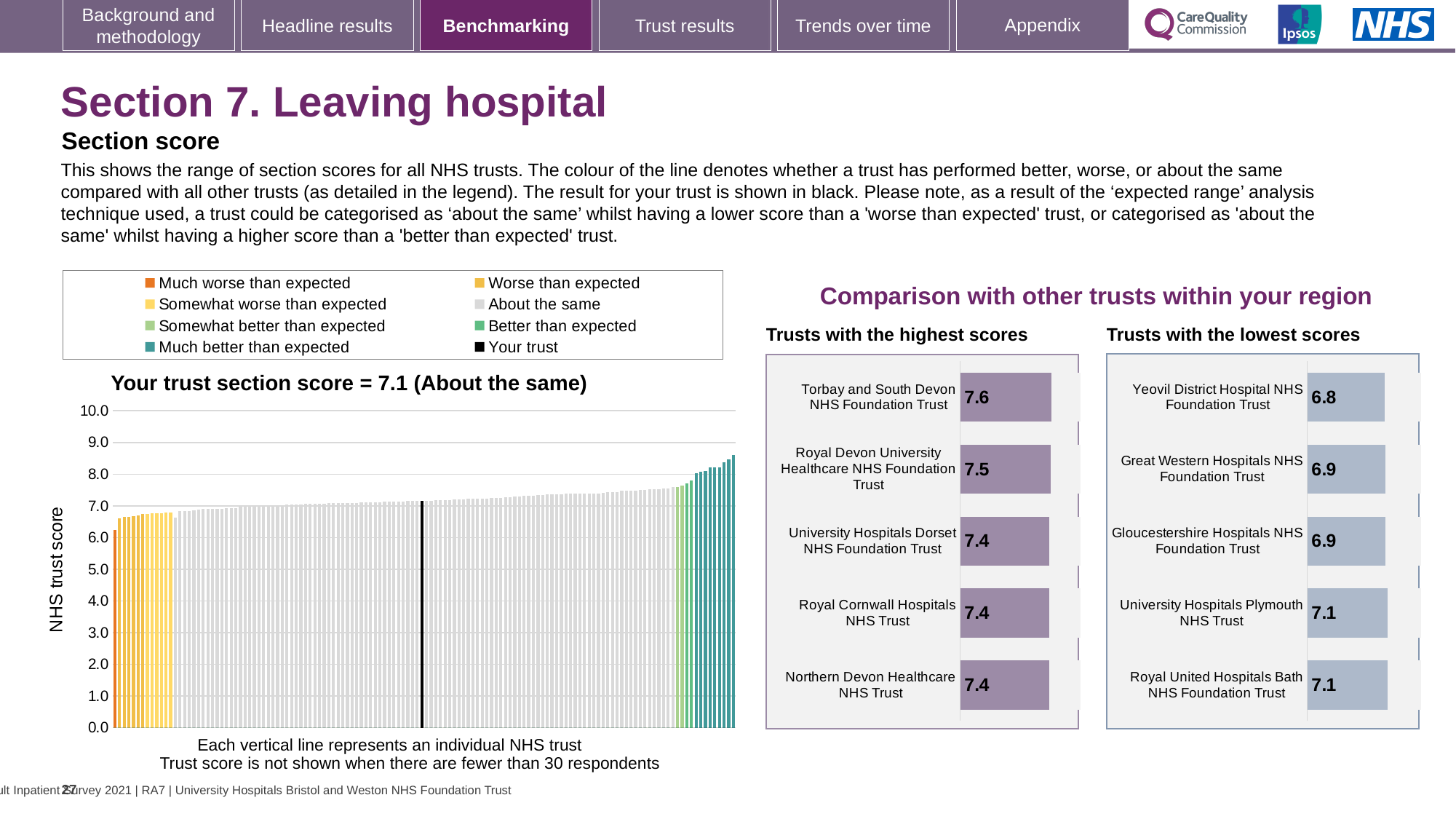
What kind of chart is the 'Your trust section score' chart on the left of the slide? bar chart In the 'Trusts with the highest scores' chart, what is the score for Torbay and South Devon NHS Foundation Trust? 7.6 In the 'Trusts with the highest scores' chart, how many trusts are shown? 5 In the 'Your trust section score' chart, is the value of the leftmost bar greater or less than 7.0? less In the 'Trusts with the lowest scores' chart, which trust has the lowest score? Yeovil District Hospital NHS Foundation Trust What is the y-axis label of the 'Your trust section score' chart? NHS trust score How many entries does the legend above the 'Your trust section score' chart list? 8 In the 'Your trust section score' chart, what is the section score for your trust? 7.1 In the 'Your trust section score' chart, is the value of the rightmost bar greater or less than 8.0? greater In the 'Trusts with the highest scores' chart, what is the difference between the scores of Torbay and South Devon NHS Foundation Trust and Royal Devon University Healthcare NHS Foundation Trust? 0.1 In the 'Trusts with the lowest scores' chart, which has the larger score: Great Western Hospitals NHS Foundation Trust or University Hospitals Plymouth NHS Trust? University Hospitals Plymouth NHS Trust In the 'Your trust section score' chart, do the bars rise or fall from left to right? rise